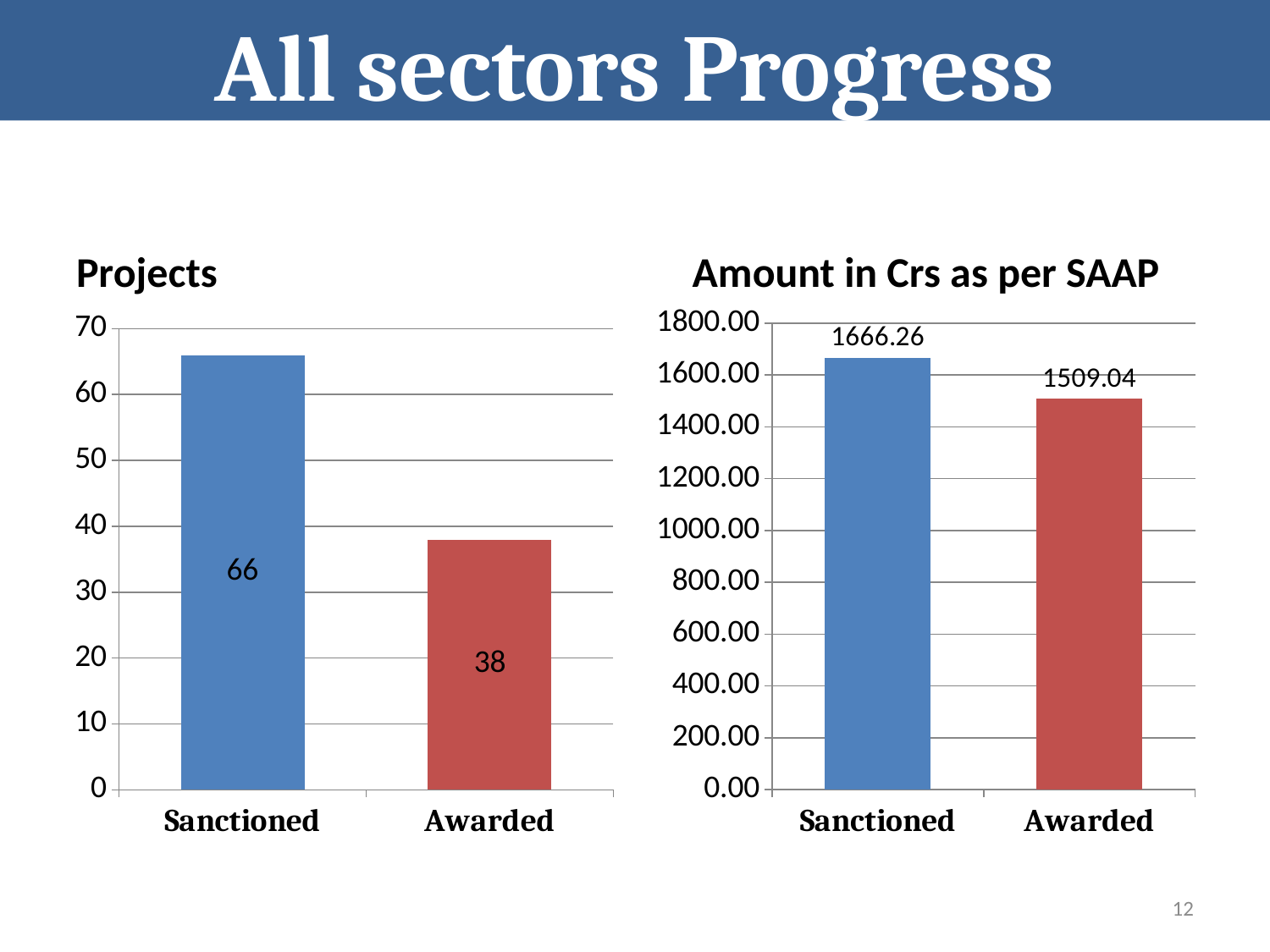
In the Amount in Crs as per SAAP chart, is the value for Sanctioned greater or less than 1600.00? greater In the Amount in Crs as per SAAP chart, what is the difference between Sanctioned and Awarded? 157.22 In the Amount in Crs as per SAAP chart, what is the value for Sanctioned? 1666.26 In the Projects chart, what is the value for Sanctioned? 66 How many categories are shown in the Projects chart? 2 In the Projects chart, which category has the highest value? Sanctioned In the Projects chart, what is the value for Awarded? 38 In the Amount in Crs as per SAAP chart, what is the value for Awarded? 1509.04 In the Projects chart, what is the difference between Sanctioned and Awarded? 28 What kind of chart is the Amount in Crs as per SAAP chart? bar chart What is the title of the chart on the left side of the slide? Projects In the Amount in Crs as per SAAP chart, which category has the lowest value? Awarded